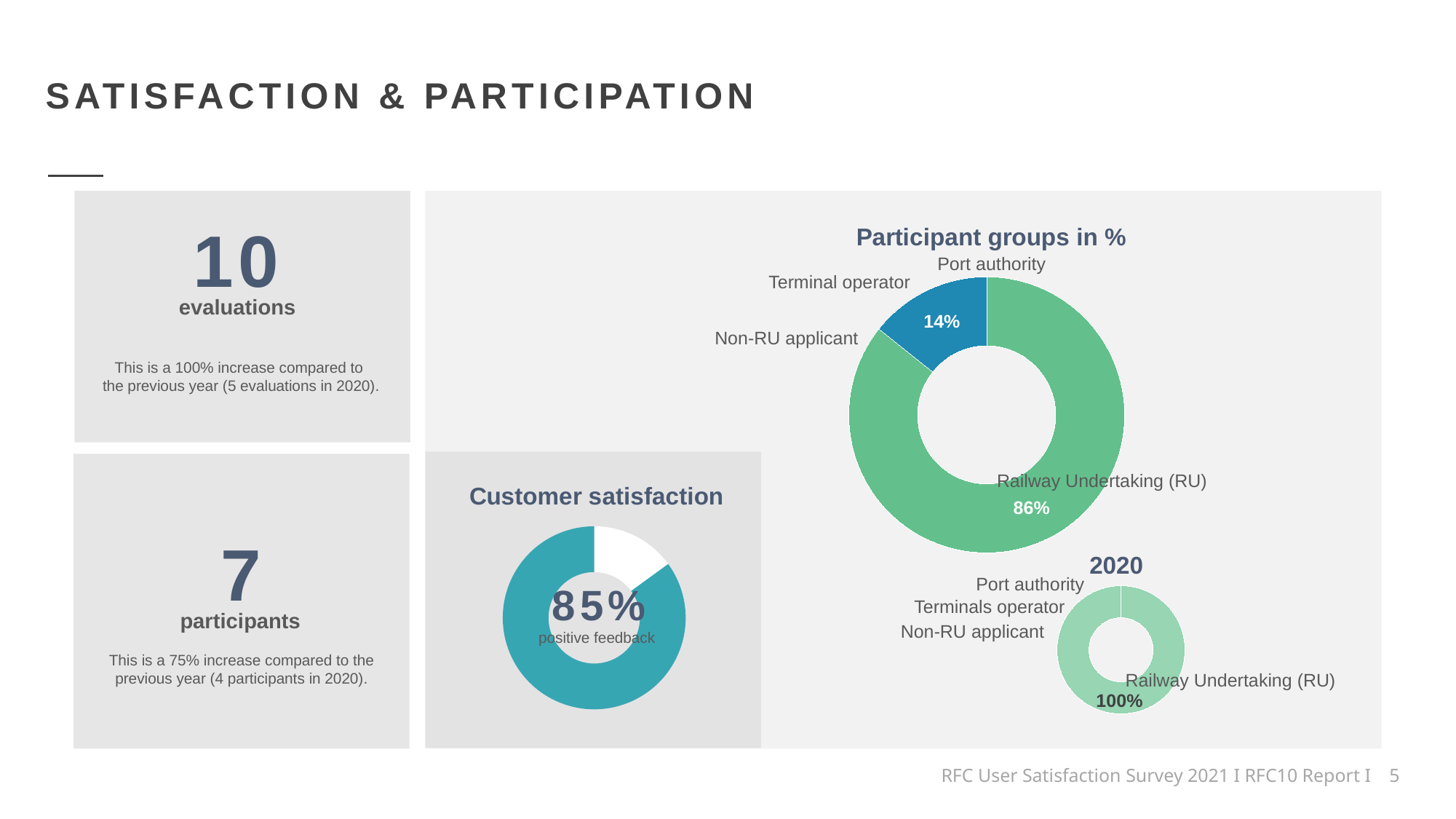
In the 'Participant groups in %' chart, what colour is the Terminal operator segment? Blue How many participant group labels are listed around the '2020' chart? 4 In the 'Participant groups in %' chart, what share is shown for Terminal operator? 14% In the 'Participant groups in %' chart, what is the difference between the Railway Undertaking (RU) share and the Terminal operator share? 72% What type of chart is the 'Customer satisfaction' chart? Donut chart What type of chart is the 'Participant groups in %' chart? Donut chart What is the title of the chart in the top right of the slide? Participant groups in % In the 'Participant groups in %' chart, which is larger: the share for Railway Undertaking (RU) or the share for Terminal operator? Railway Undertaking (RU) In the 'Participant groups in %' chart, which participant group has the largest share? Railway Undertaking (RU) In the 'Customer satisfaction' chart, what percentage of positive feedback is shown? 85% In the 'Participant groups in %' chart, what share is shown for Railway Undertaking (RU)? 86% In the '2020' chart, what share is shown for Railway Undertaking (RU)? 100%